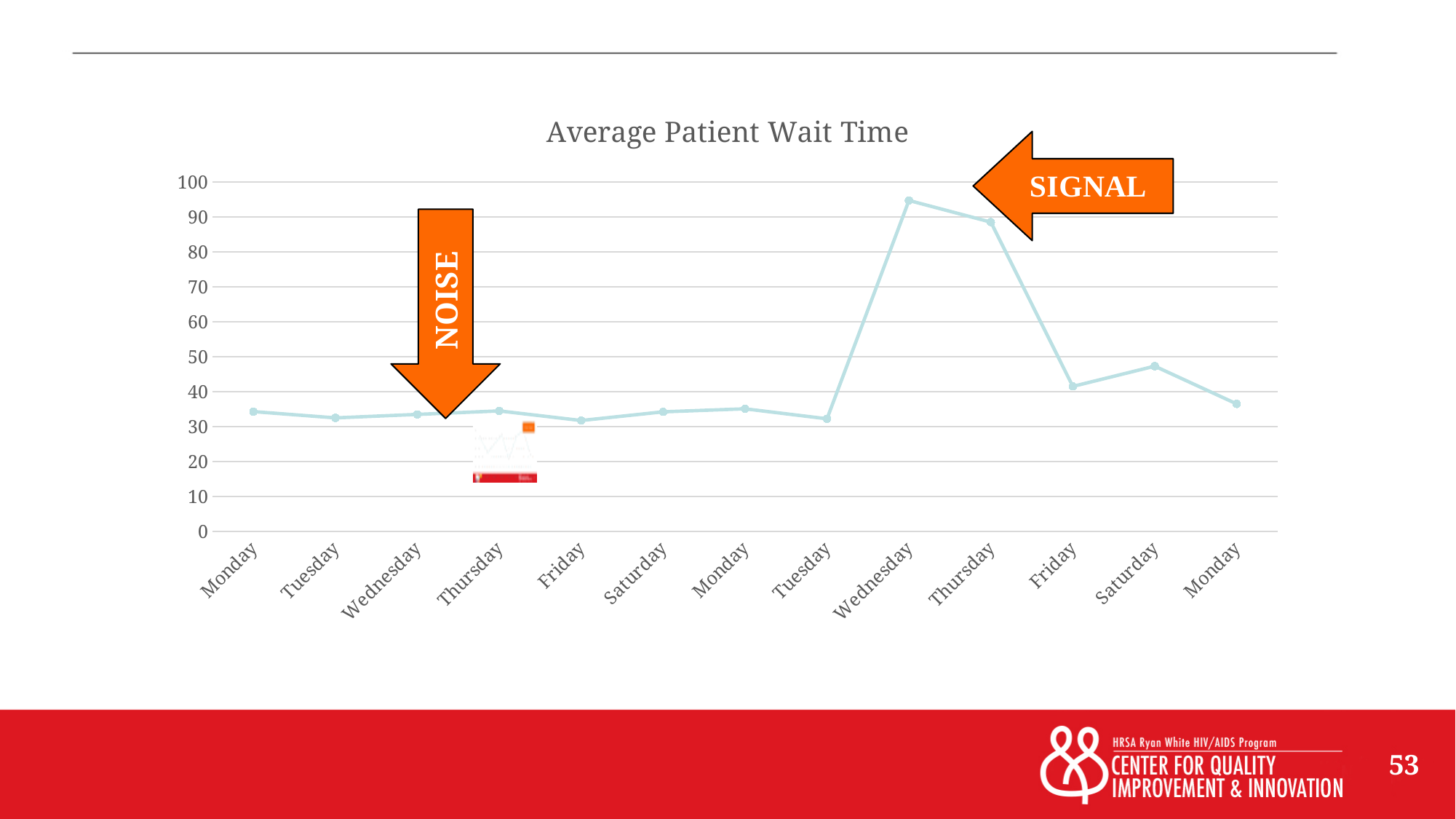
Do the values rise or fall from the second Wednesday to the second Friday? fall Which is larger, the value for the second Wednesday or the value for the second Thursday? the second Wednesday What word is written on the orange arrow pointing at the two high points on the right of the chart? SIGNAL Is the value for the second Thursday greater or less than 80? greater Is the value for the second Saturday greater or less than 40? greater Which is larger, the value for the second Friday or the value for the second Saturday? the second Saturday What is the title of the chart? Average Patient Wait Time Which category has the highest average patient wait time? the second Wednesday Is the value for the second Wednesday greater or less than 90? greater What kind of chart is shown on the slide? line chart How many data points are plotted on the line? 13